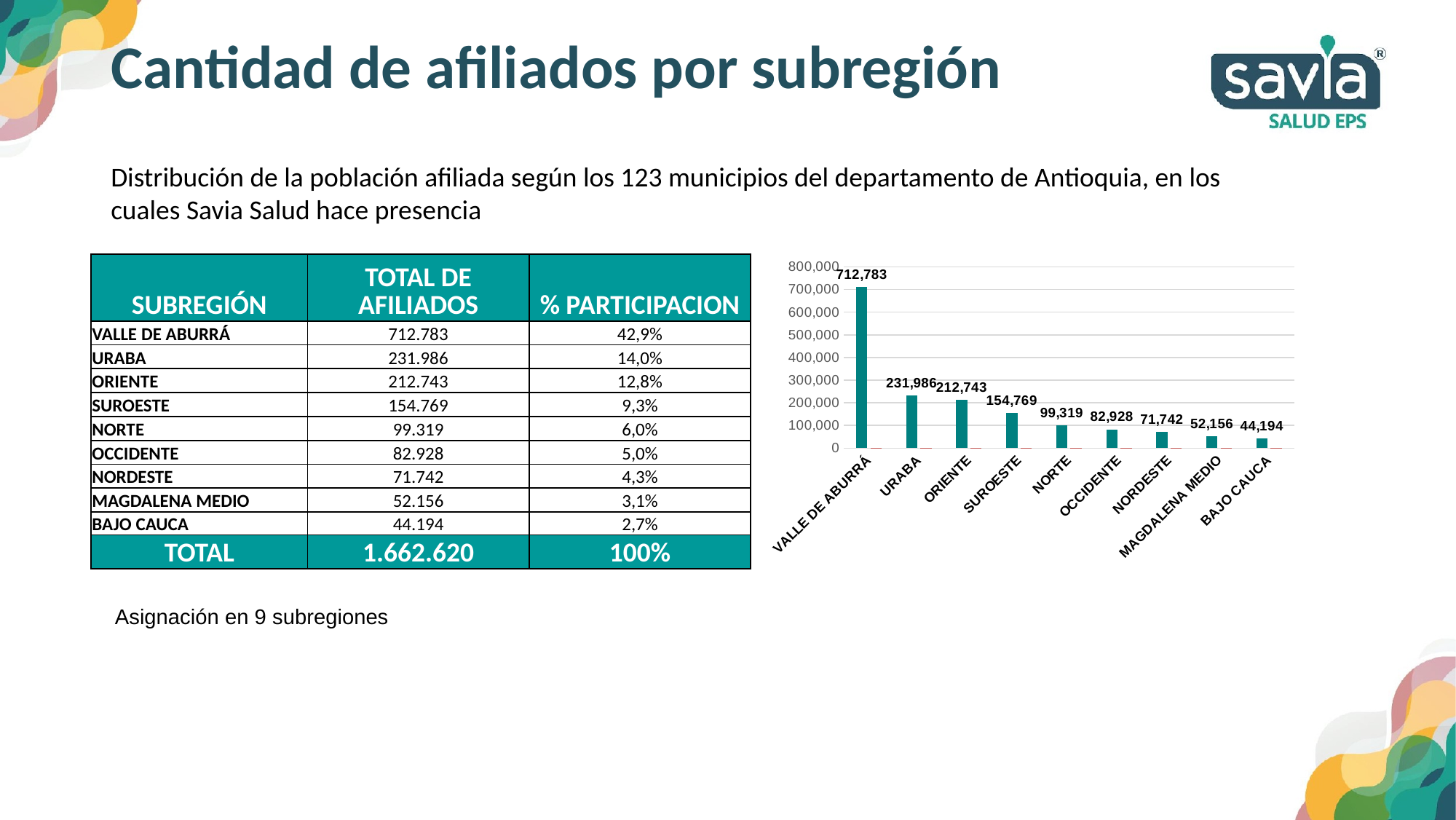
What is the difference between the values for URABA and ORIENTE in the chart? 19,243 Which has a larger value in the chart, NORDESTE or OCCIDENTE? OCCIDENTE What kind of chart is shown on the slide? bar chart What is the value shown for SUROESTE in the chart? 154,769 What is the value shown for MAGDALENA MEDIO in the chart? 52,156 Which subregion has the lowest value in the chart? BAJO CAUCA Is the value for URABA in the chart greater or less than 200,000? greater What is the difference between the values for NORTE and OCCIDENTE in the chart? 16,391 Do the values in the chart rise or fall from left to right along the x axis? fall How many subregions are plotted in the chart? 9 What is the value shown for VALLE DE ABURRÁ in the chart? 712,783 Which subregion has the highest value in the chart? VALLE DE ABURRÁ